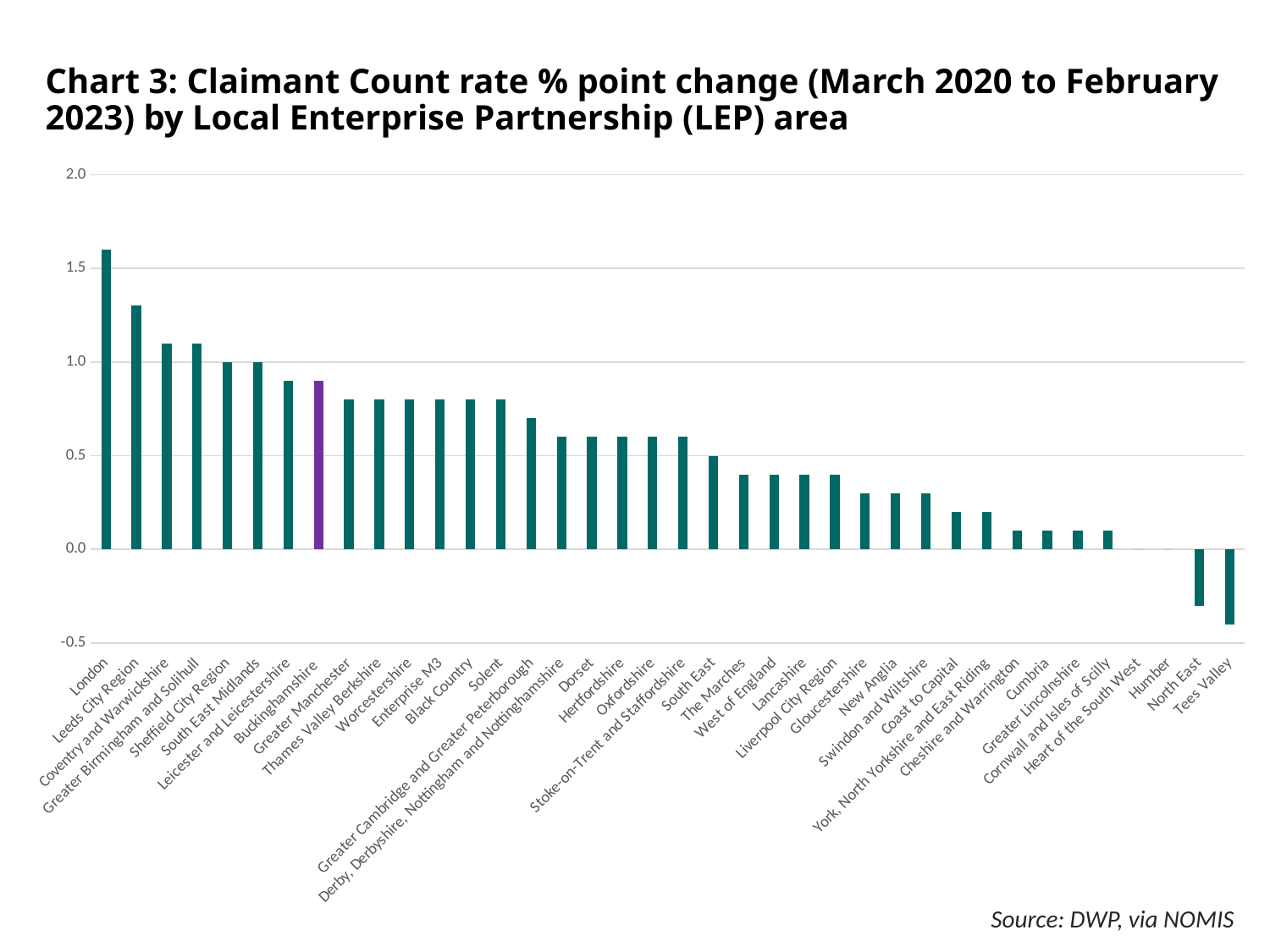
How many LEP areas are shown on the chart? 38 What type of chart is shown on the slide? Bar chart Is the value for North East greater or less than 0.0? less Which LEP area has the highest Claimant Count rate % point change? London Is the value for Leeds City Region greater or less than 1.0? greater Which has the larger value, London or Leeds City Region? London Do the values generally rise or fall moving from left to right along the x axis? Fall Which LEP area has the lowest Claimant Count rate % point change? Tees Valley Is the value for Cumbria greater or less than 0.5? less Which LEP area's bar is shown in purple rather than green? Buckinghamshire